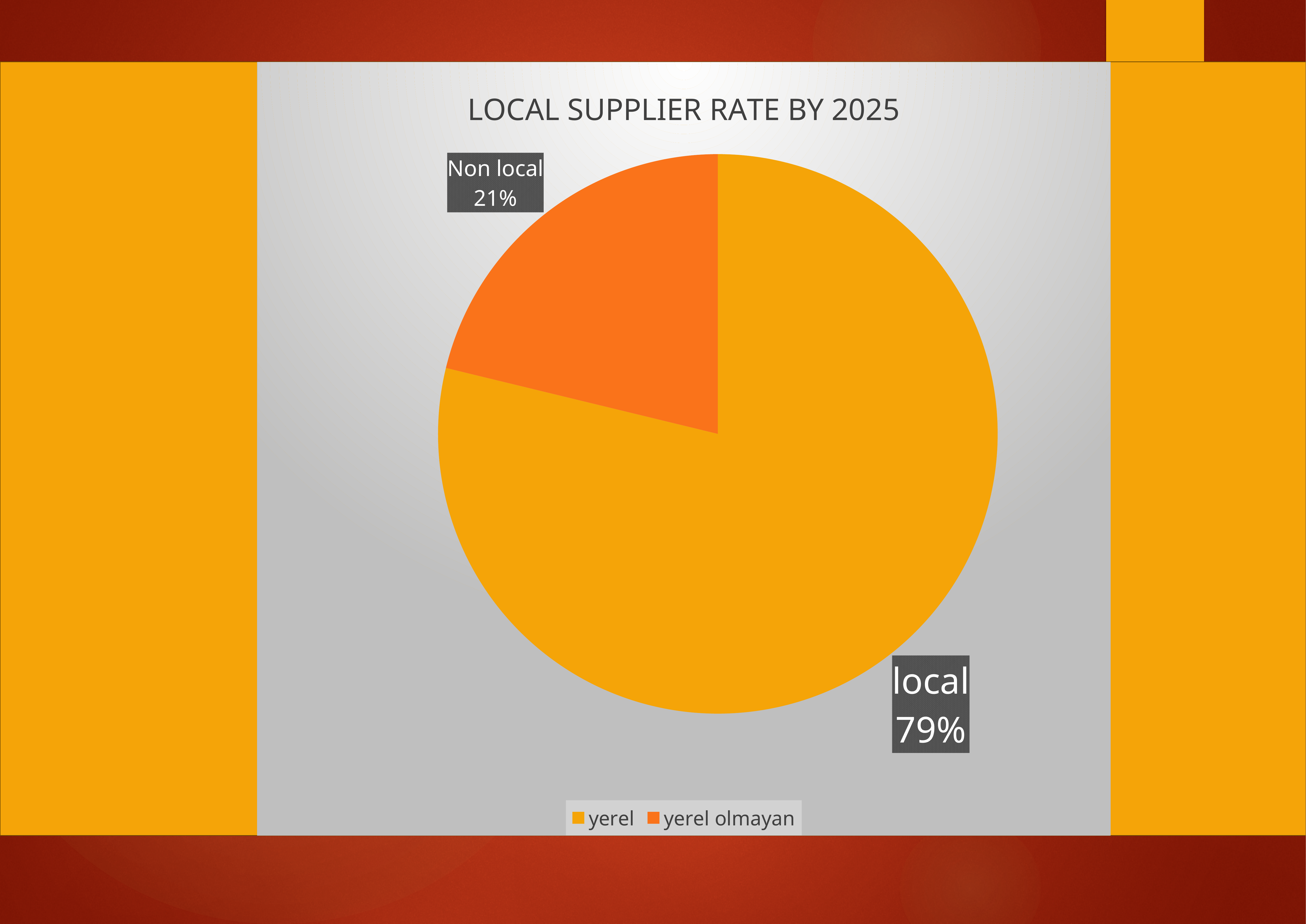
Is the share for Non local greater or less than 25%? less Which slice is the smallest? Non local How many slices does the pie chart have? 2 Which is larger, the local slice or the Non local slice? local What are the two entries listed in the legend? yerel, yerel olmayan What kind of chart is shown on the slide? pie chart What share of the pie is labelled Non local? 21% What share of the pie is labelled local? 79% How many entries does the legend list? 2 What is the difference in percentage points between the local and Non local slices? 58 What is the title of the chart? LOCAL SUPPLIER RATE BY 2025 Which slice is the largest? local